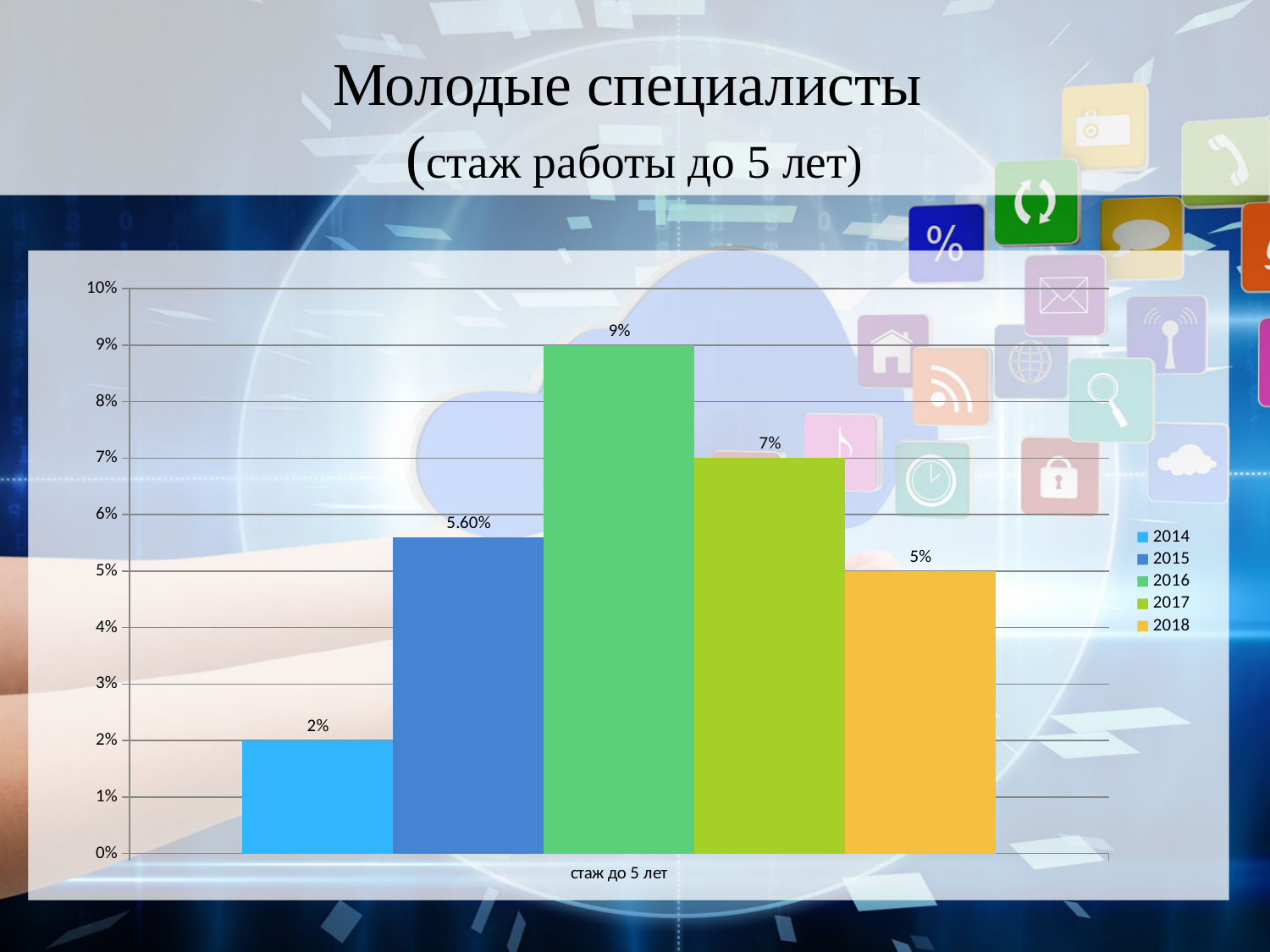
Which year has the highest value? 2016 Which is larger, the value for 2015 or the value for 2018? 2015 How many series does the legend list? 5 What kind of chart is shown on the slide? bar chart What is the value for 2016? 9% What is the category label shown on the x axis? стаж до 5 лет What is the difference between the values for 2016 and 2017? 2% Is the value for 2017 greater or less than 6%? greater What is the value for 2014? 2% Which year has the lowest value? 2014 What is the value for 2018? 5% What is the value for 2015? 5.60%